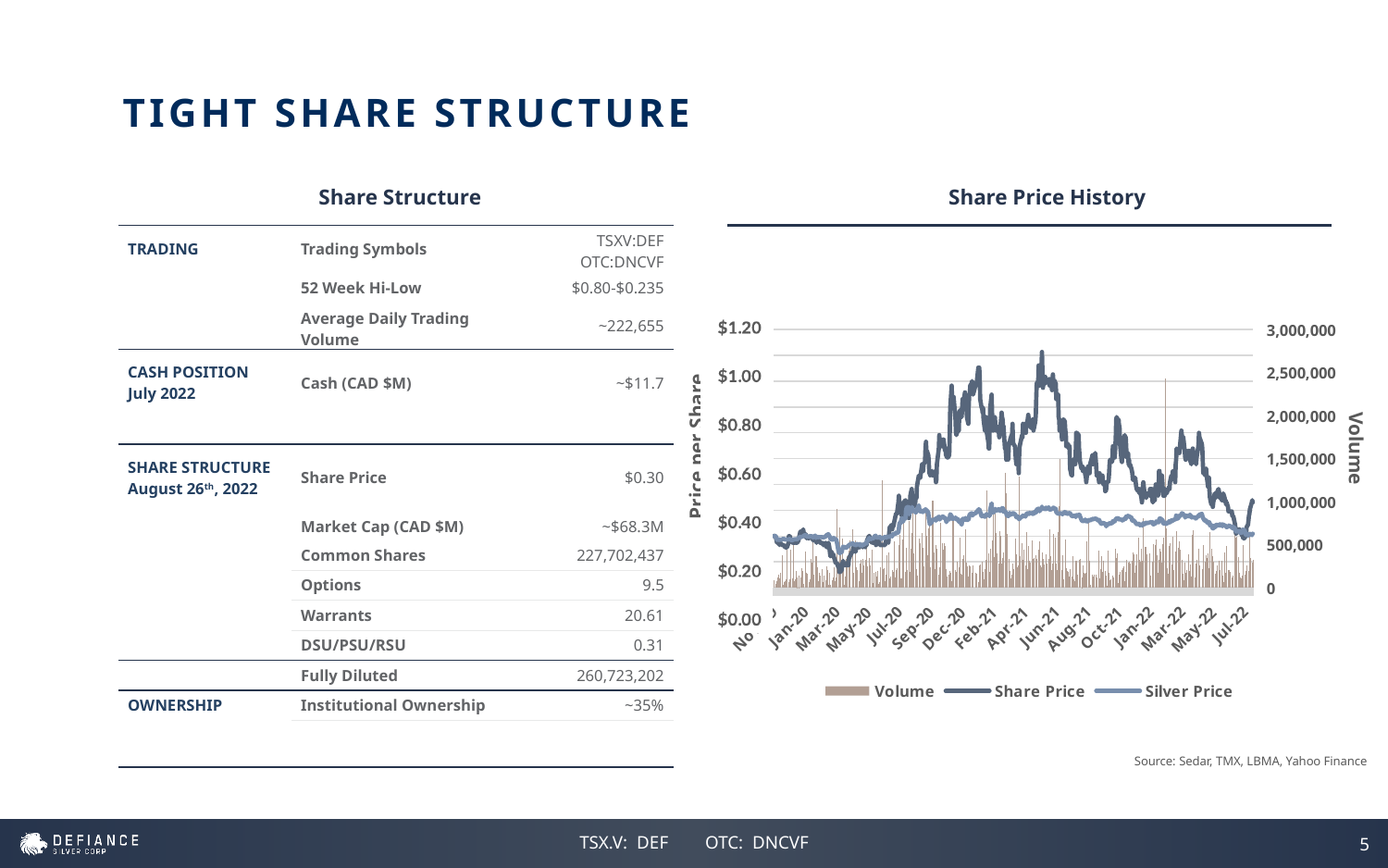
In the Share Price History chart, which line reaches the higher price: Share Price or Silver Price? Share Price What kind of chart is the Share Price History chart? Combination chart with volume bars and two lines In the Share Price History chart, does the Share Price rise or fall between Mar-20 and Feb-21? rise How many series does the legend of the Share Price History chart list? 3 In the Share Price History chart, is the tallest Volume bar greater or less than 2,000,000? greater In the Share Price History chart, does the Share Price rise or fall between Jun-21 and Jul-22? fall In the Share Price History chart, around Jun-21, which is higher: the Share Price or the Silver Price? Share Price What is the title of the chart on the slide? Share Price History In the Share Price History chart, which series is plotted as bars? Volume In the Share Price History chart, is the peak of the Share Price line greater or less than $1.00? greater In the Share Price History chart, is the Share Price at Jul-22 greater or less than $0.60? less